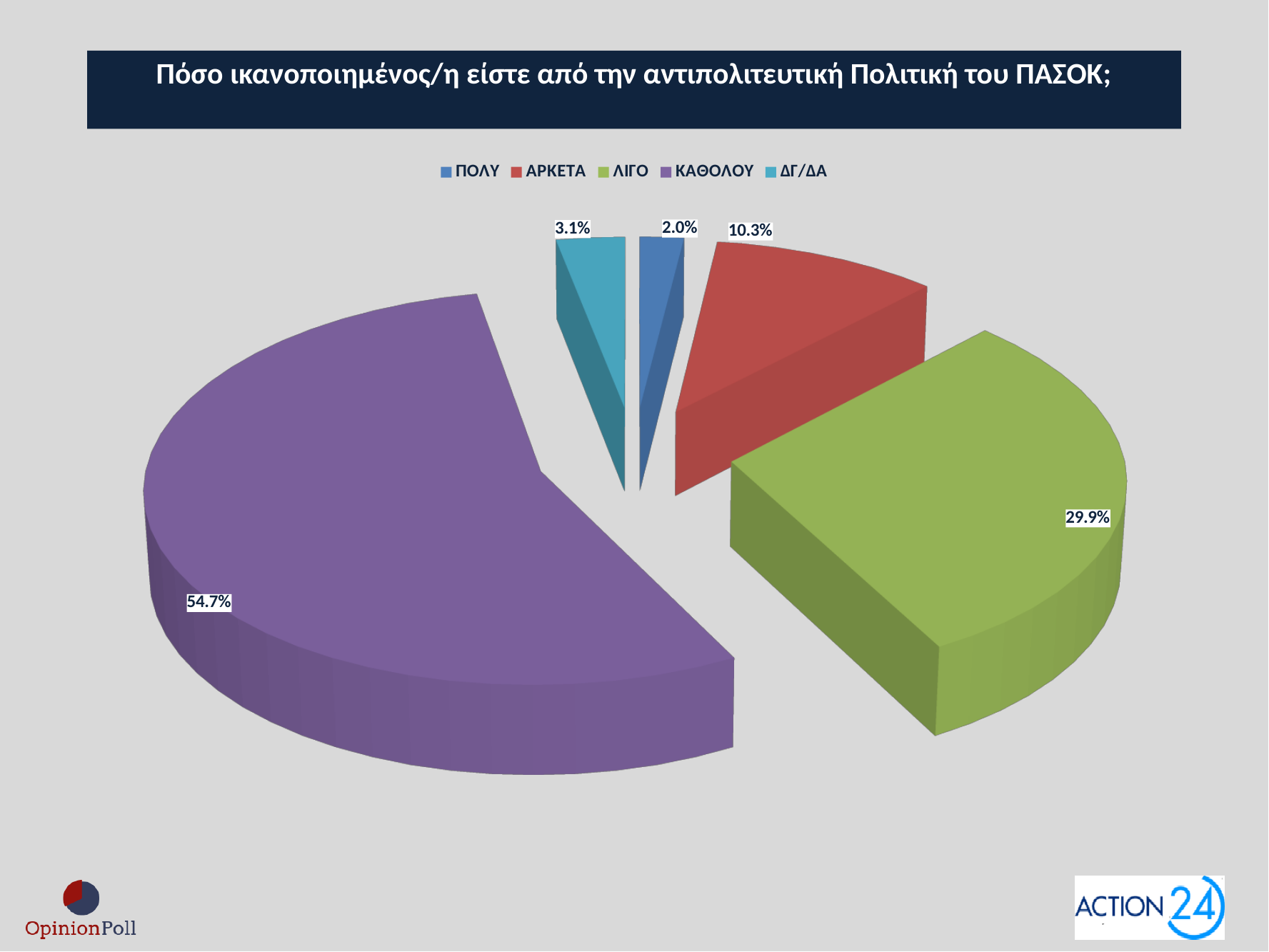
What colour is the ΛΙΓΟ slice? Green What is the difference in percentage points between ΚΑΘΟΛΟΥ and ΛΙΓΟ? 24.8 What percentage is shown for ΚΑΘΟΛΟΥ? 54.7% What percentage is shown for ΑΡΚΕΤΑ? 10.3% How many categories does the legend list? 5 What kind of chart is shown on the slide? Pie chart Which category has the smallest share of the pie? ΠΟΛΥ Which is larger, the share for ΑΡΚΕΤΑ or the share for ΔΓ/ΔΑ? ΑΡΚΕΤΑ Which category has the largest share of the pie? ΚΑΘΟΛΟΥ What percentage is shown for ΠΟΛΥ? 2.0% What percentage is shown for ΛΙΓΟ? 29.9% What percentage is shown for ΔΓ/ΔΑ? 3.1%